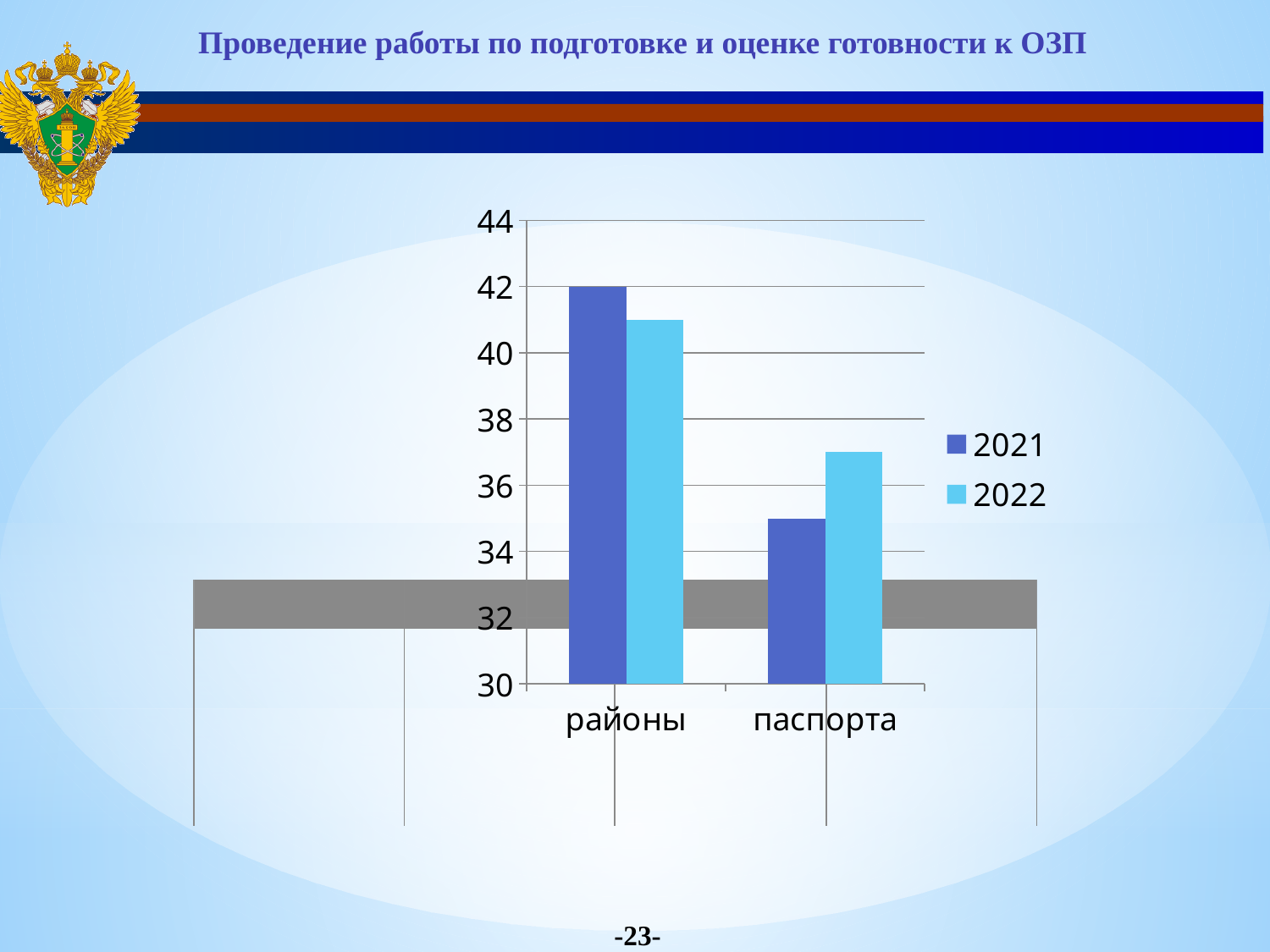
How many categories are shown on the x axis? 2 Which category has the lowest value in the 2022 series? паспорта Is the value for паспорта in the 2022 series greater or less than 36? greater How many series does the legend list? 2 For паспорта, which series has the larger value, 2021 or 2022? 2022 Is the value for паспорта in the 2021 series greater or less than 36? less What kind of chart is shown on the slide? bar chart What is the value for районы in the 2021 series? 42 For районы, which series has the larger value, 2021 or 2022? 2021 Which category has the highest value in the 2021 series? районы Is the value for районы in the 2022 series greater or less than 40? greater What are the two series names listed in the legend? 2021 and 2022